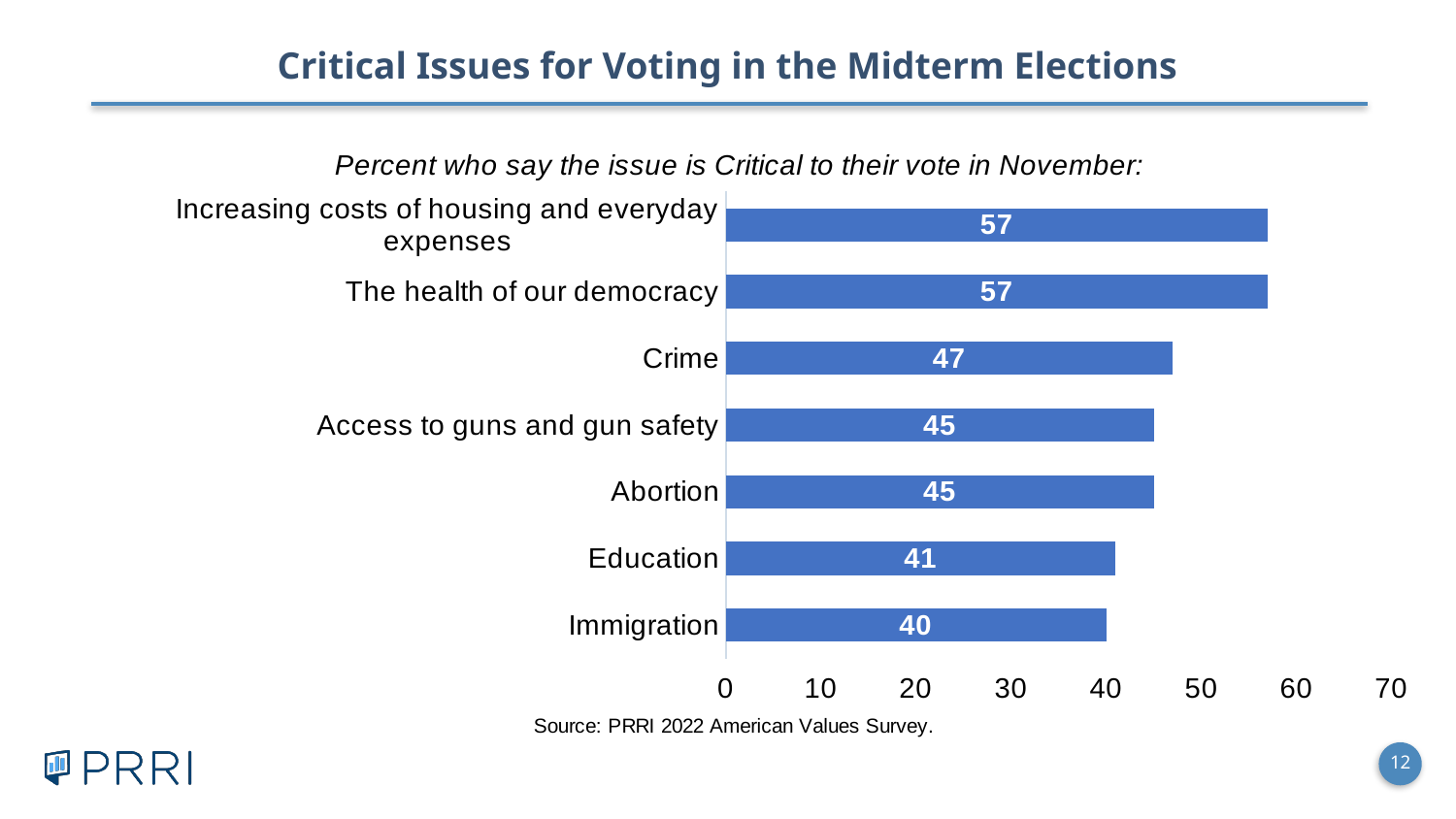
Which issue has the lowest value on the chart? Immigration What percent say Crime is critical to their vote in November? 47 What is the value for Immigration? 40 What is the difference between the values for Increasing costs of housing and everyday expenses and Education? 16 What kind of chart is shown on the slide? bar chart What is the difference between the values for Crime and Immigration? 7 How many issues are shown on the chart? 7 What is the source cited below the chart? PRRI 2022 American Values Survey Which is larger, the value for Crime or the value for Abortion? Crime Is the value for Access to guns and gun safety greater or less than 50? less What is the value for The health of our democracy? 57 What is the value for Education? 41